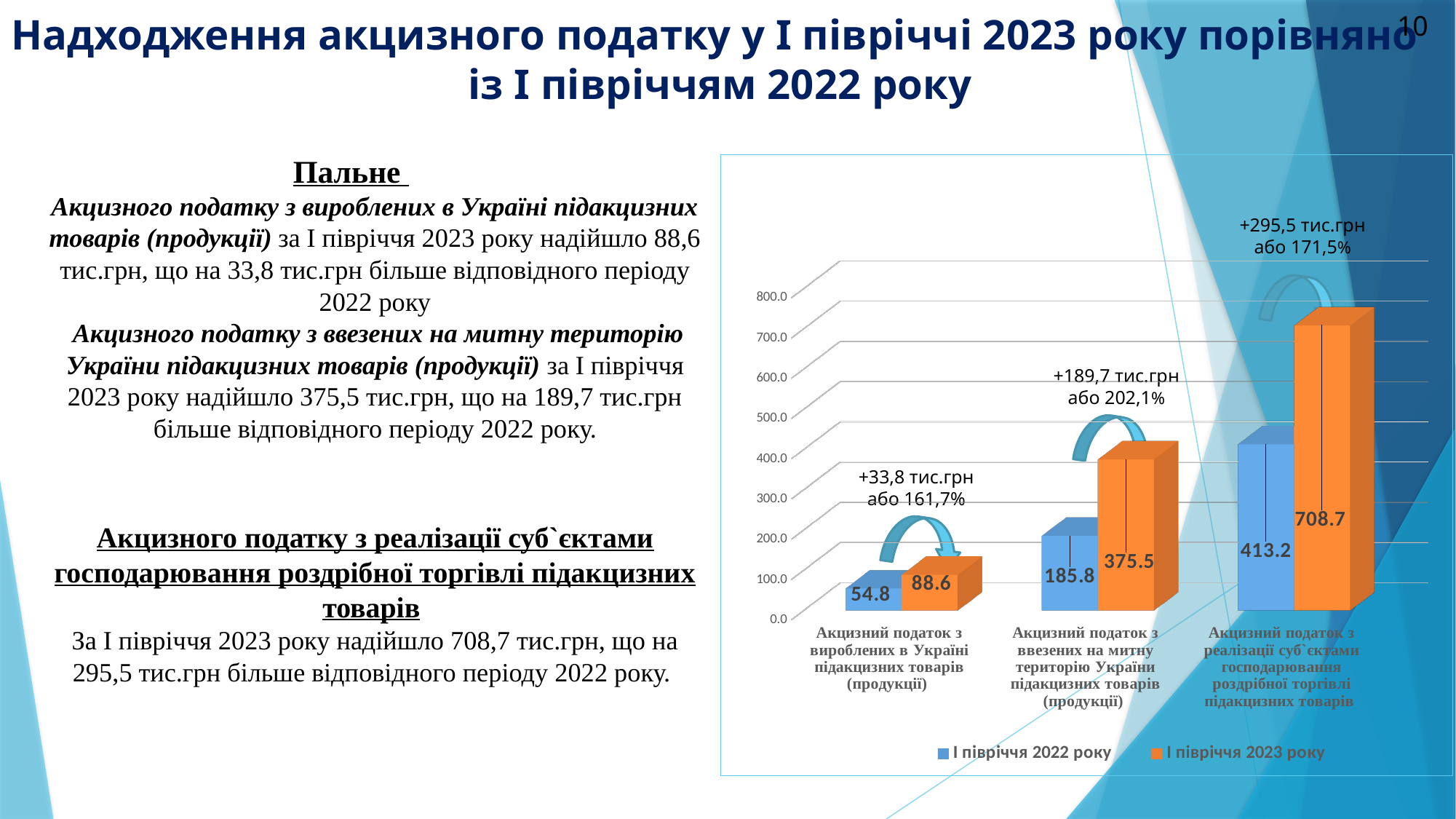
What percentage growth is annotated above the bars for 'Акцизний податок з реалізації суб`єктами господарювання роздрібної торгівлі підакцизних товарів'? 171,5% How many series does the chart legend list? 2 Which category has the highest value for 'I півріччя 2022 року'? Акцизний податок з реалізації суб`єктами господарювання роздрібної торгівлі підакцизних товарів What is the value for 'I півріччя 2023 року' in the category 'Акцизний податок з реалізації суб`єктами господарювання роздрібної торгівлі підакцизних товарів'? 708.7 What is the difference between the 'I півріччя 2023 року' and 'I півріччя 2022 року' values in the category 'Акцизний податок з ввезених на митну територію України підакцизних товарів (продукції)'? 189.7 Which is larger: the 'I півріччя 2022 року' value for 'Акцизний податок з реалізації суб`єктами господарювання роздрібної торгівлі підакцизних товарів' or the 'I півріччя 2023 року' value for 'Акцизний податок з ввезених на митну територію України підакцизних товарів (продукції)'? I півріччя 2022 року value for Акцизний податок з реалізації суб`єктами господарювання роздрібної торгівлі підакцизних товарів (413.2) What type of chart is shown on the slide? Bar chart What is the value for 'I півріччя 2022 року' in the category 'Акцизний податок з ввезених на митну територію України підакцизних товарів (продукції)'? 185.8 Which category has the lowest value for 'I півріччя 2023 року'? Акцизний податок з вироблених в Україні підакцизних товарів (продукції) What is the value for 'I півріччя 2023 року' in the category 'Акцизний податок з вироблених в Україні підакцизних товарів (продукції)'? 88.6 Do the values for 'I півріччя 2023 року' rise or fall from left to right along the x axis? Rise How many categories are shown on the x axis of the chart? 3